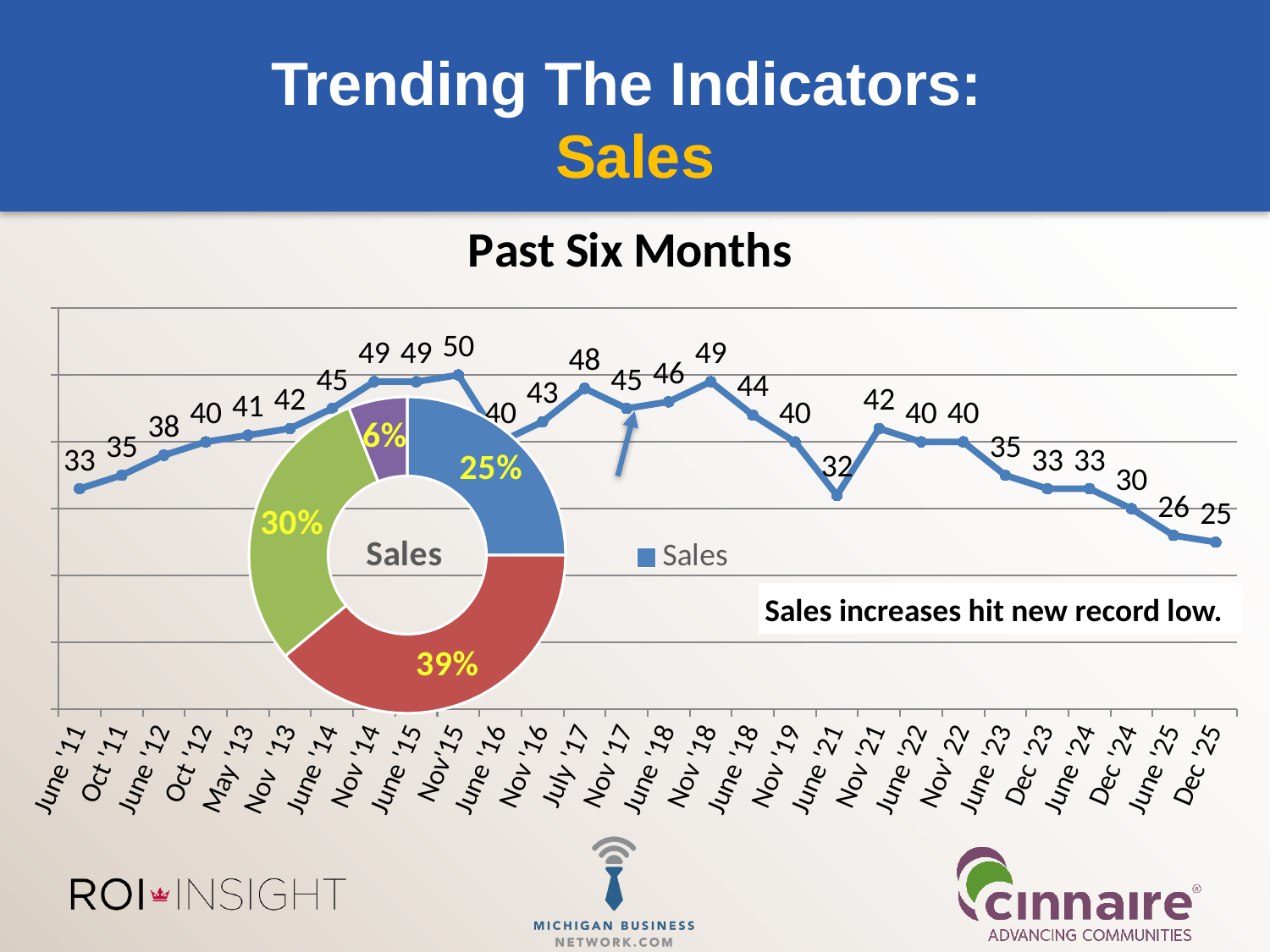
On the line chart, what is the Sales value for June '21? 32 On the line chart, which is larger, the Sales value for July '17 or for Nov '17? July '17 On the line chart, which period has the lowest Sales value? Dec '25 On the line chart, do the Sales values rise or fall from June '22 to Dec '25? Fall On the line chart, what is the Sales value for Dec '25? 25 How many slices does the donut chart titled 'Sales' have? 4 On the line chart, which period has the highest Sales value? Nov '15 On the line chart, what is the Sales value for Nov '15? 50 How many data points are plotted on the line chart? 28 What kind of chart is the 'Past Six Months' chart? Line chart On the donut chart titled 'Sales', what is the share of the largest slice? 39% On the line chart, what is the difference between the Sales values for Nov '15 and Dec '25? 25